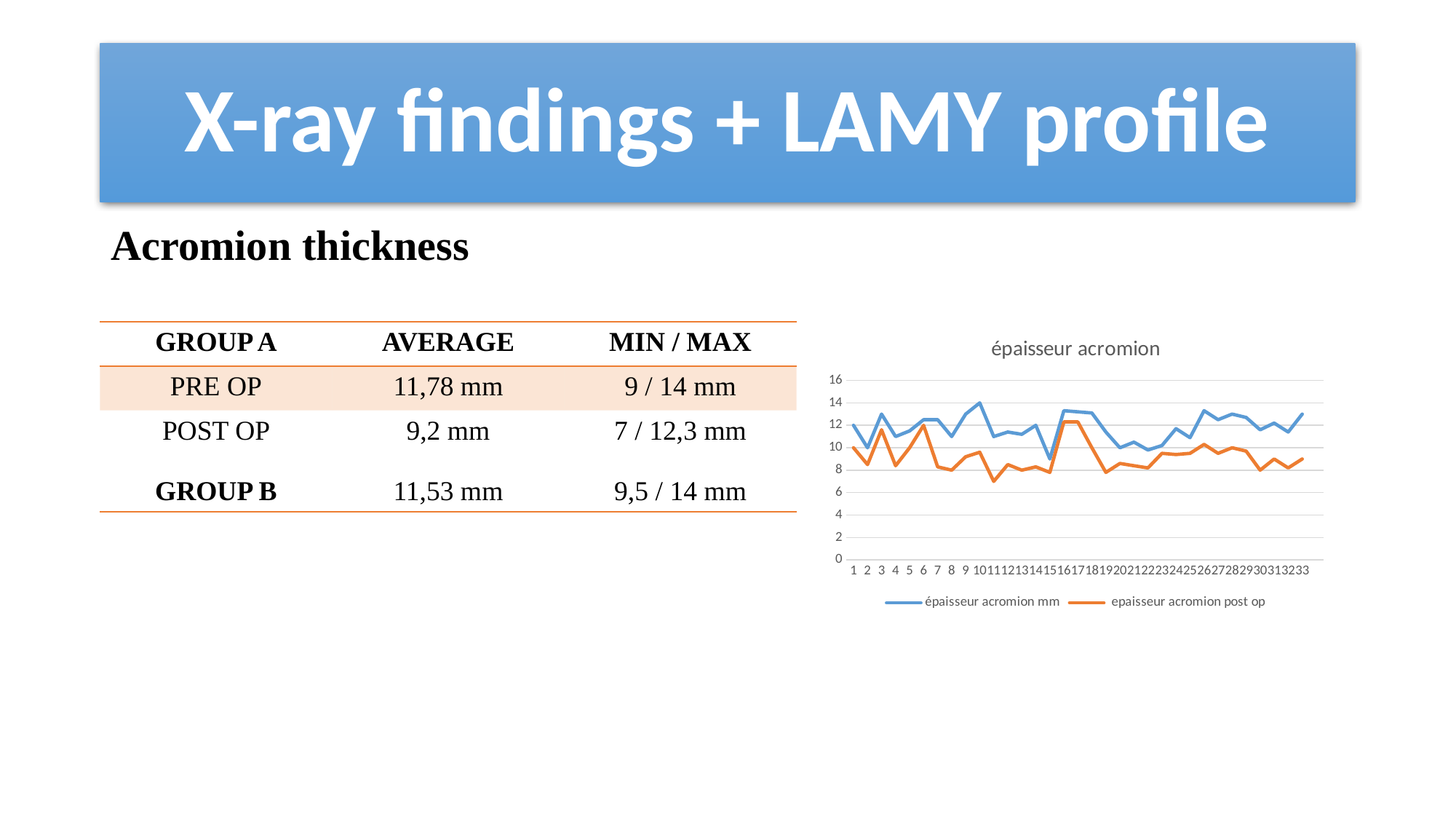
Which series is drawn in orange in the chart? epaisseur acromion post op What kind of chart is shown on the slide? line chart Is the value of the epaisseur acromion post op series at point 19 greater or less than 10? less How many series does the legend of the chart list? 2 At point 10, which series has the higher value, épaisseur acromion mm or epaisseur acromion post op? épaisseur acromion mm Is the value of the épaisseur acromion mm series at point 2 greater or less than 12? less How many points are on the x axis of the chart? 33 Is the value of the epaisseur acromion post op series at point 11 greater or less than 8? less At point 3, which series has the higher value, épaisseur acromion mm or epaisseur acromion post op? épaisseur acromion mm What is the title of the chart? épaisseur acromion